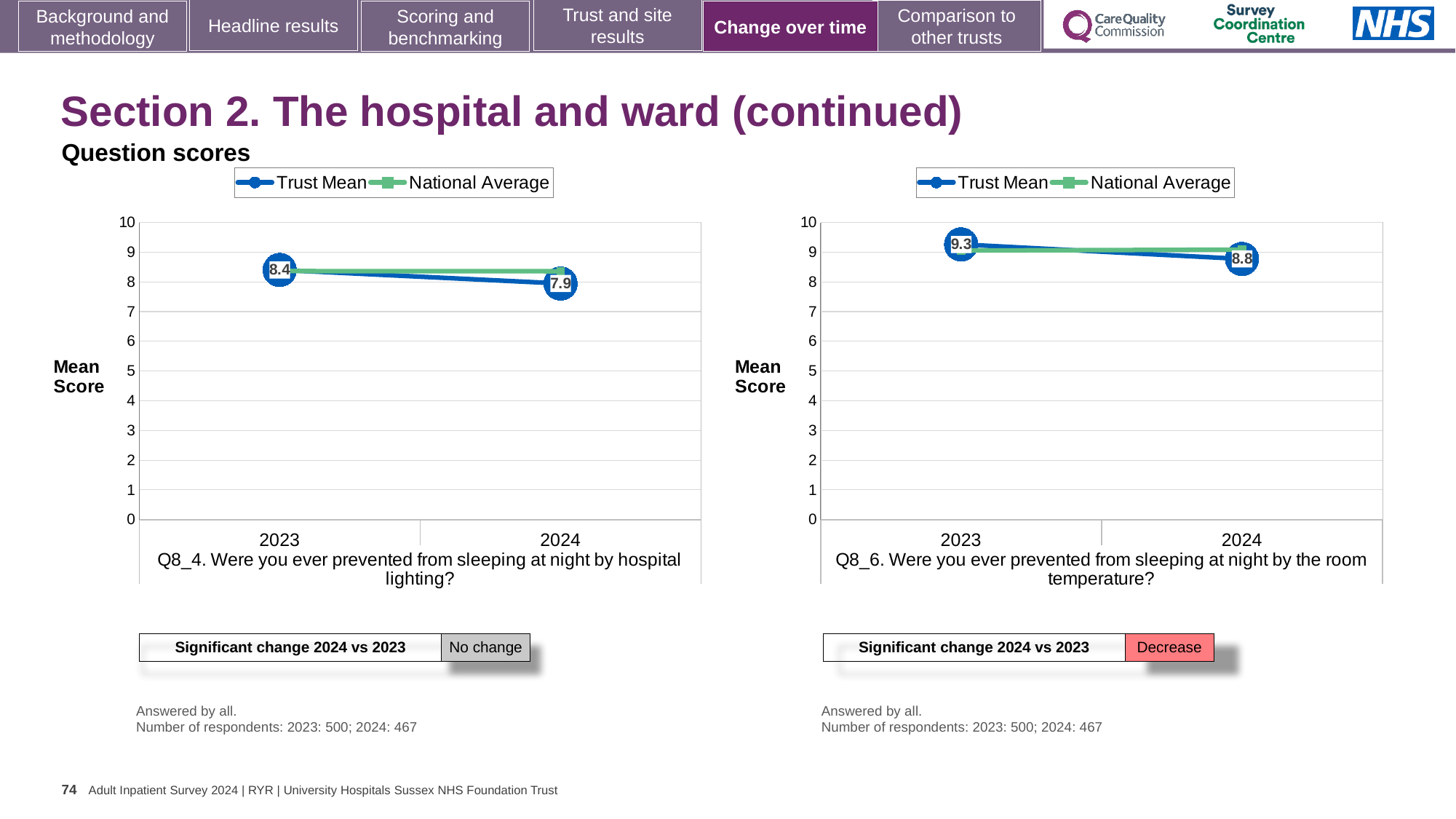
What kind of chart is the Q8_6 room temperature chart? line chart How many series does the legend of the Q8_4 hospital lighting chart list? 2 In the Q8_4 hospital lighting chart, by how much did the Trust Mean change from 2023 to 2024? 0.5 In the Q8_6 room temperature chart, what is the difference between the Trust Mean scores for 2023 and 2024? 0.5 In the Q8_4 hospital lighting chart, is the National Average for 2024 greater or less than 8? greater In the Q8_6 room temperature chart, what is the Trust Mean score for 2023? 9.3 In the Q8_4 hospital lighting chart, what is the Trust Mean score for 2024? 7.9 How many years are shown on the x axis of the Q8_6 room temperature chart? 2 In the Q8_6 room temperature chart, what is the Trust Mean score for 2024? 8.8 In the Q8_4 hospital lighting chart, which year has the higher Trust Mean score? 2023 In the Q8_4 hospital lighting chart, what is the Trust Mean score for 2023? 8.4 In the Q8_6 room temperature chart, does the Trust Mean rise or fall from 2023 to 2024? fall